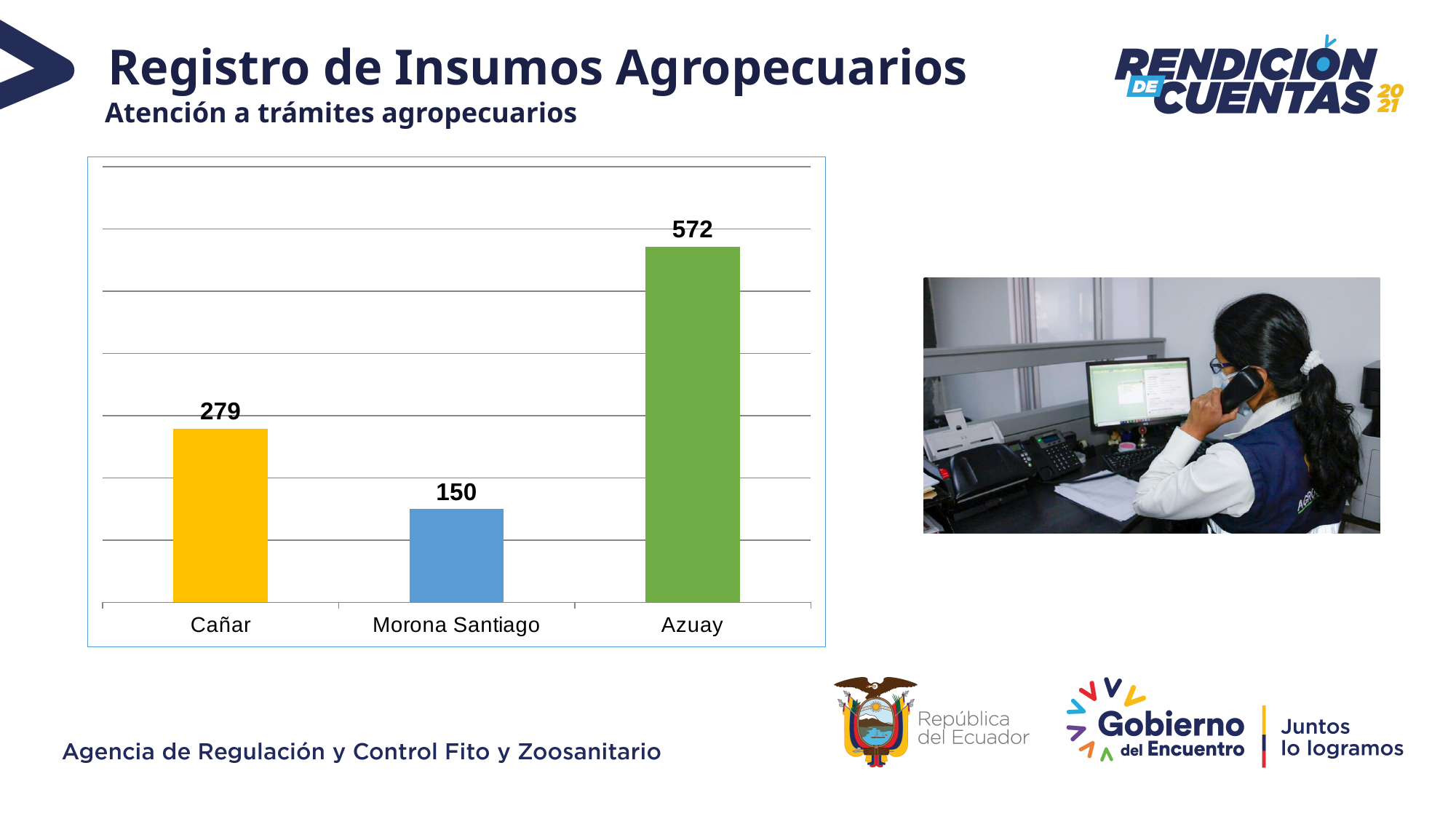
Which category has the highest value? Azuay Which is larger, the value for Cañar or the value for Morona Santiago? Cañar Which category has the lowest value? Morona Santiago What kind of chart is shown on the slide? Bar chart How many categories are shown in the chart? 3 What is the difference between the values for Cañar and Morona Santiago? 129 What is the value for Cañar? 279 What colour is the bar for Azuay? Green What is the difference between the values for Azuay and Cañar? 293 What is the value for Morona Santiago? 150 What is the value for Azuay? 572 What is the total of the three values shown in the chart? 1001